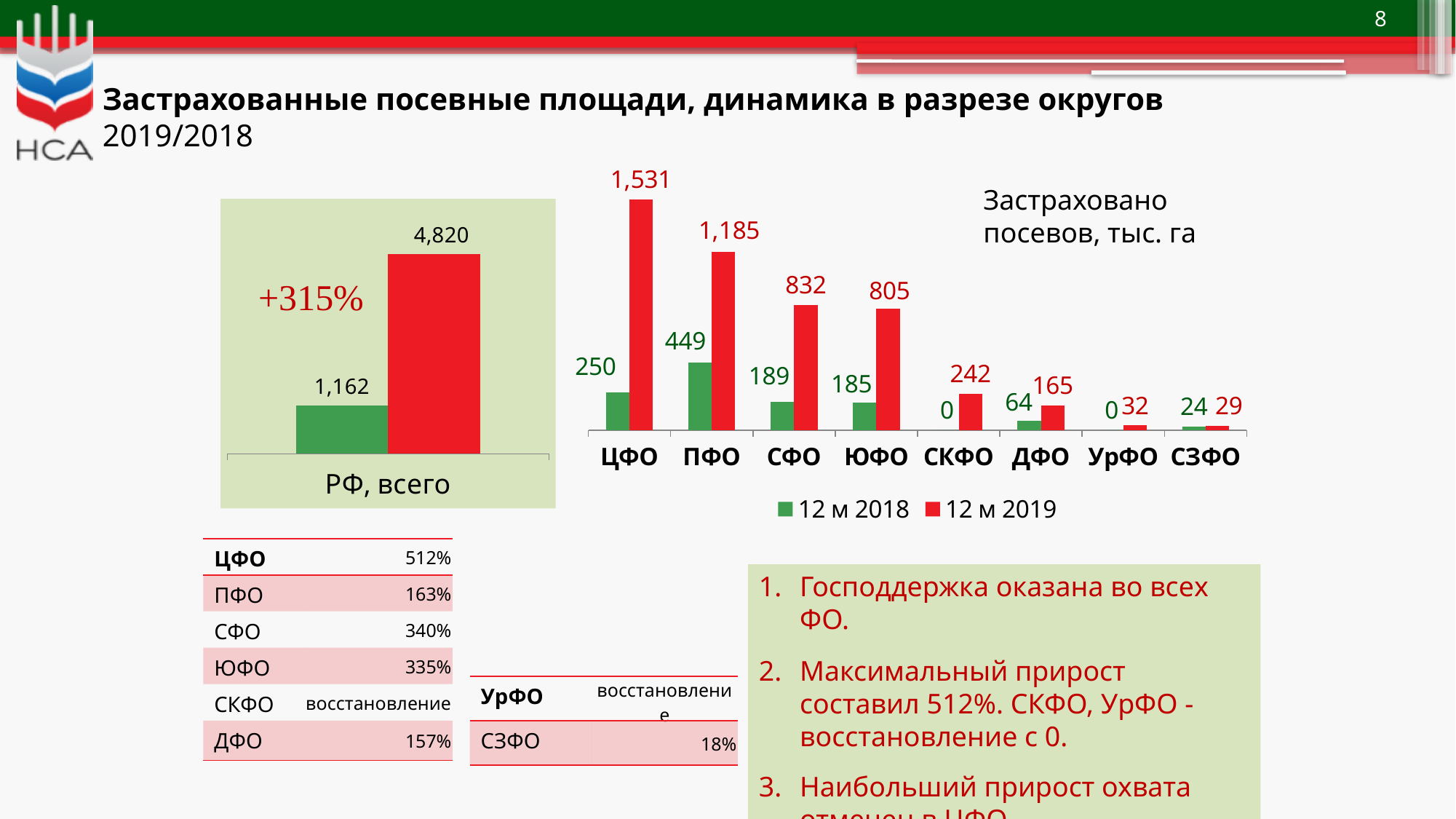
How many districts are shown on the x axis of the right-hand chart? 8 In the right-hand chart, which district has the highest value in the 12 м 2019 series? ЦФО What percentage change is printed inside the left-hand chart titled РФ, всего? +315% In the left-hand chart titled РФ, всего, what is the difference between the red bar and the green bar? 3,658 In the right-hand chart, what is the value for ПФО in the 12 м 2018 series? 449 How many series does the legend of the right-hand chart list? 2 In the right-hand chart, which is larger: the 12 м 2019 value for ЮФО or the 12 м 2019 value for СКФО? ЮФО In the right-hand chart, what is the difference between the 12 м 2019 and 12 м 2018 values for СФО? 643 In the right-hand chart, what is the value for ЦФО in the 12 м 2019 series? 1,531 In the right-hand chart, which district has the lowest value in the 12 м 2019 series? СЗФО What kind of chart is the right-hand chart? Bar chart In the left-hand chart titled РФ, всего, what is the value of the red bar? 4,820